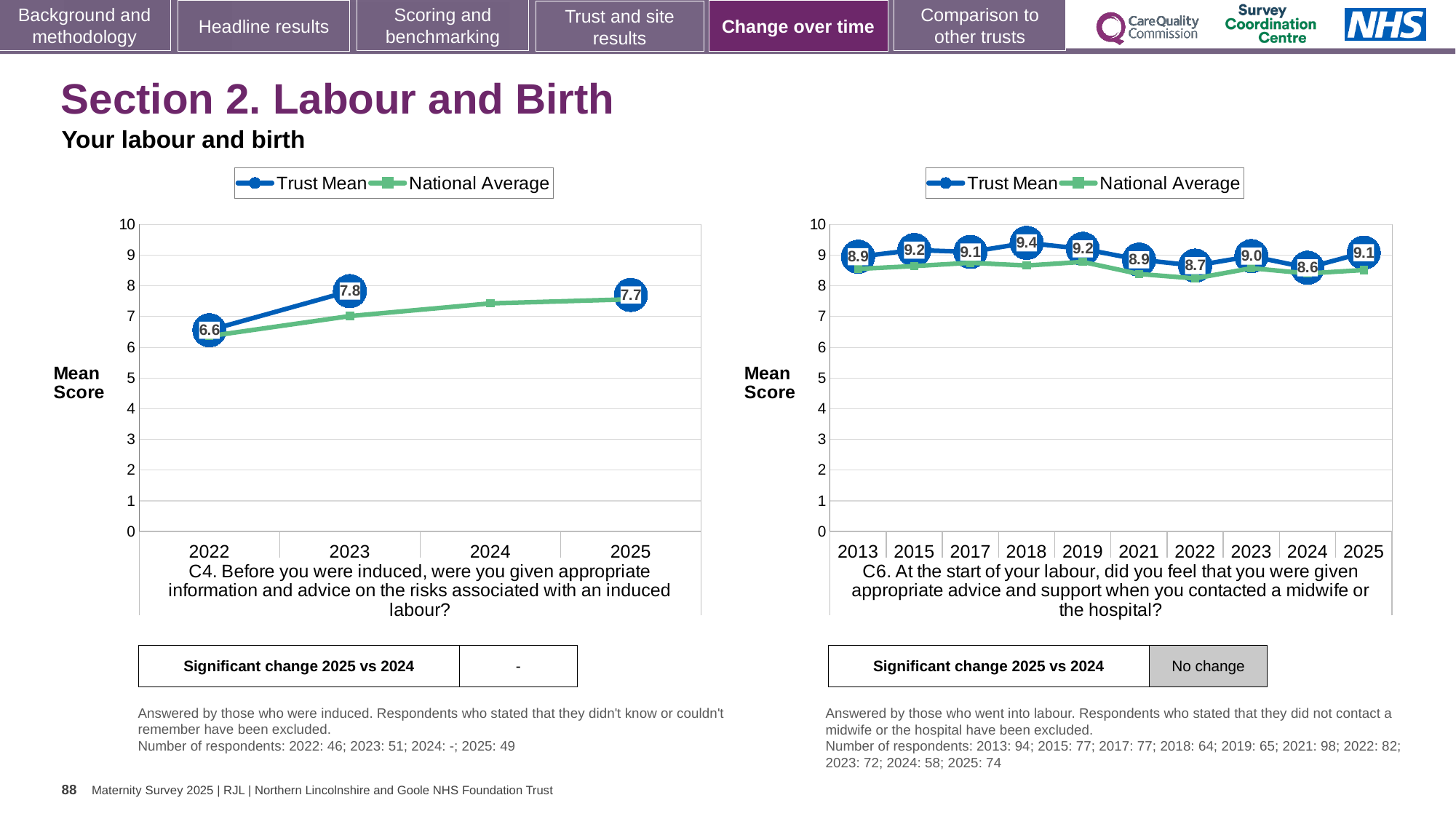
What type of chart is the C6 chart on the right? Line chart In the C4 chart on the left, how many series does the legend list? 2 In the C6 chart on the right, what is the difference between the Trust Mean scores for 2025 and 2024? 0.5 In the C6 chart on the right, which year has the lowest Trust Mean score? 2024 In the C4 chart on the left, what is the Trust Mean score for 2022? 6.6 In the C4 chart on the left, what is the Trust Mean score for 2023? 7.8 In the C4 chart on the left, what is the Trust Mean score for 2025? 7.7 In the C6 chart on the right, what is the Trust Mean score for 2024? 8.6 In the C6 chart on the right, which year has the highest Trust Mean score? 2018 In the C6 chart on the right, what is the Trust Mean score for 2018? 9.4 In the C4 chart on the left, by how much did the Trust Mean rise from 2022 to 2023? 1.2 In the C6 chart on the right, how many years are shown on the x axis? 10